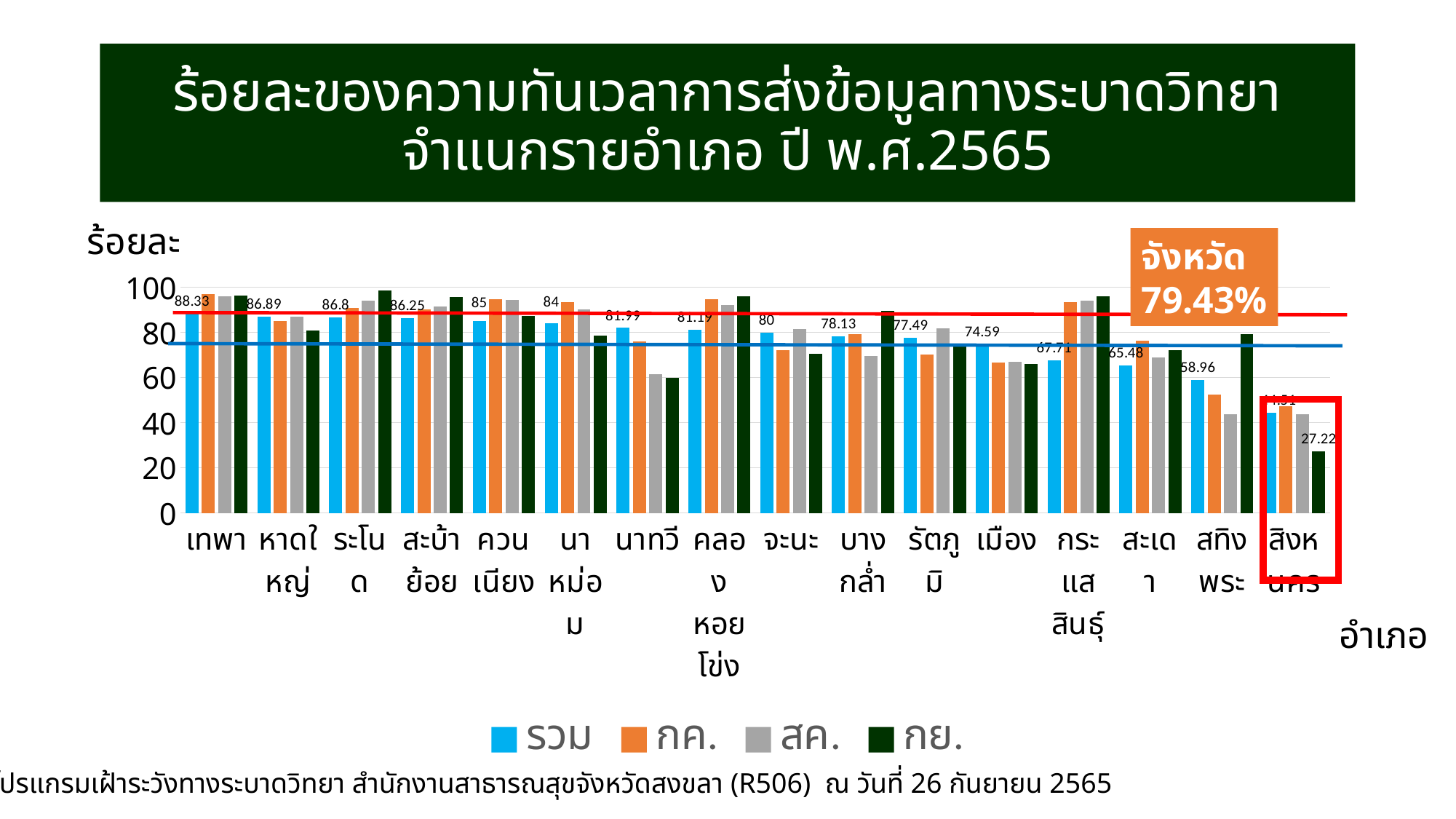
What kind of chart is shown on the slide? bar chart What is the รวม value for สทิงพระ? 58.96 Which district has the highest รวม value? เทพา What province-level percentage (จังหวัด) is shown in the orange box? 79.43% What is the difference between the รวม values for เทพา and หาดใหญ่? 1.44 How many series does the legend list? 4 Which has the larger รวม value, จะนะ or บางกล่ำ? จะนะ Is the สค. value for นาทวี greater or less than 80? less Which district has the lowest รวม value? สิงหนคร What is the รวม value for เทพา? 88.33 What is the กย. value for สิงหนคร? 27.22 How many districts are shown on the x axis? 16